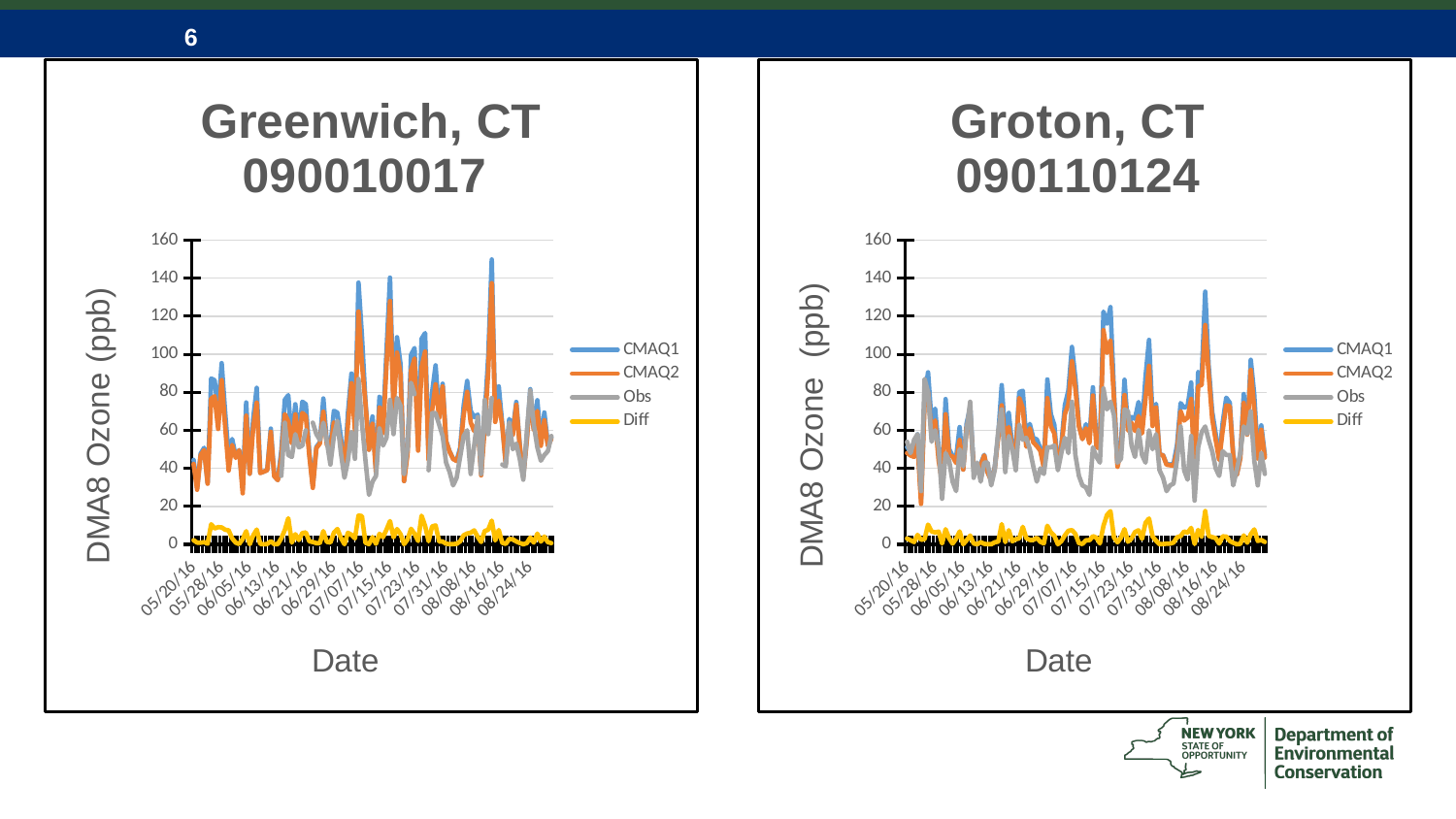
In the Groton, CT 090110124 chart, is the highest value of the Obs series greater or less than 100? less In the Groton, CT 090110124 chart, is the highest value of the CMAQ1 series greater or less than 140? less In the Greenwich, CT 090010017 chart, is the highest value of the CMAQ1 series greater or less than 140? greater How many series does the legend of the Groton, CT 090110124 chart list? 4 What kind of chart is the Greenwich, CT 090010017 chart? line chart What is the x-axis label on the Groton, CT 090110124 chart? Date How many series does the legend of the Greenwich, CT 090010017 chart list? 4 What kind of chart is the Groton, CT 090110124 chart? line chart What is the y-axis label on the Greenwich, CT 090010017 chart? DMA8 Ozone (ppb) In the Greenwich, CT 090010017 chart, which series reaches a higher peak, CMAQ1 or Diff? CMAQ1